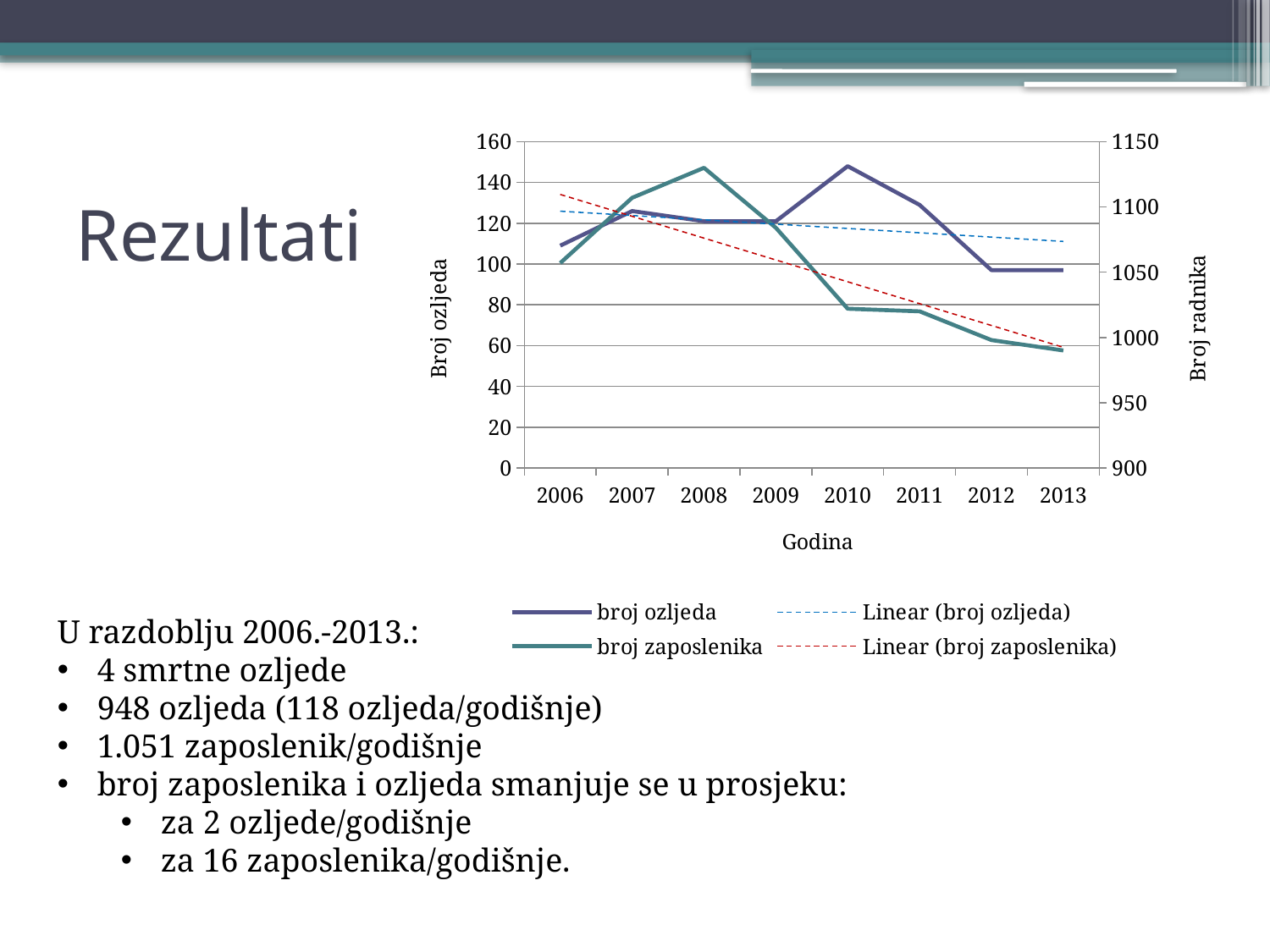
Does the broj zaposlenika line rise or fall from 2008 to 2013? fall What kind of chart is shown on the slide? line chart Which is larger, the value of broj ozljeda in 2010 or in 2006? 2010 In which year is the value of broj ozljeda highest? 2010 How many entries does the chart legend list? 4 How many years are shown on the x axis of the chart? 8 What is the title of the right-hand vertical axis of the chart? Broj radnika Is the value of broj ozljeda in 2006 greater or less than 120? less Is the value of broj zaposlenika in 2008 greater or less than 1100? greater Is the value of broj zaposlenika in 2010 greater or less than 1050? less In which year is the value of broj zaposlenika highest? 2008